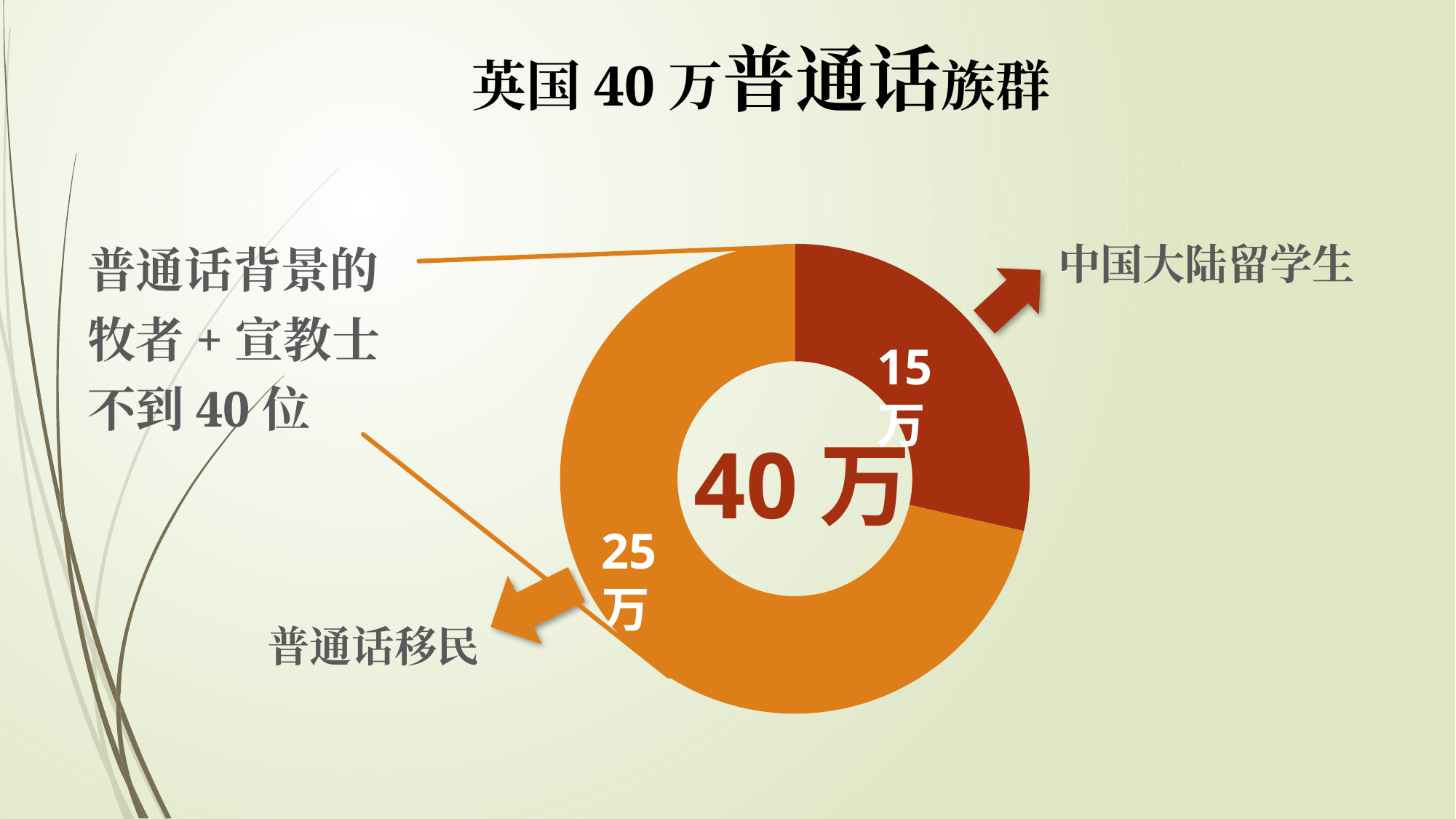
What is the total of the two segments shown in the centre of the chart? 40万 What is the value for 中国大陆留学生? 15万 What colour is the 中国大陆留学生 segment? Dark red How many segments does the doughnut chart have? 2 What share of the total does 普通话移民 represent? 62.5% Which segment is the smallest? 中国大陆留学生 Which is larger, 中国大陆留学生 or 普通话移民? 普通话移民 What is the title of the slide? 英国 40 万普通话族群 Which segment is the largest? 普通话移民 What is the value for 普通话移民? 25万 What kind of chart is shown on the slide? Doughnut chart What is the difference between the 普通话移民 and 中国大陆留学生 values? 10万